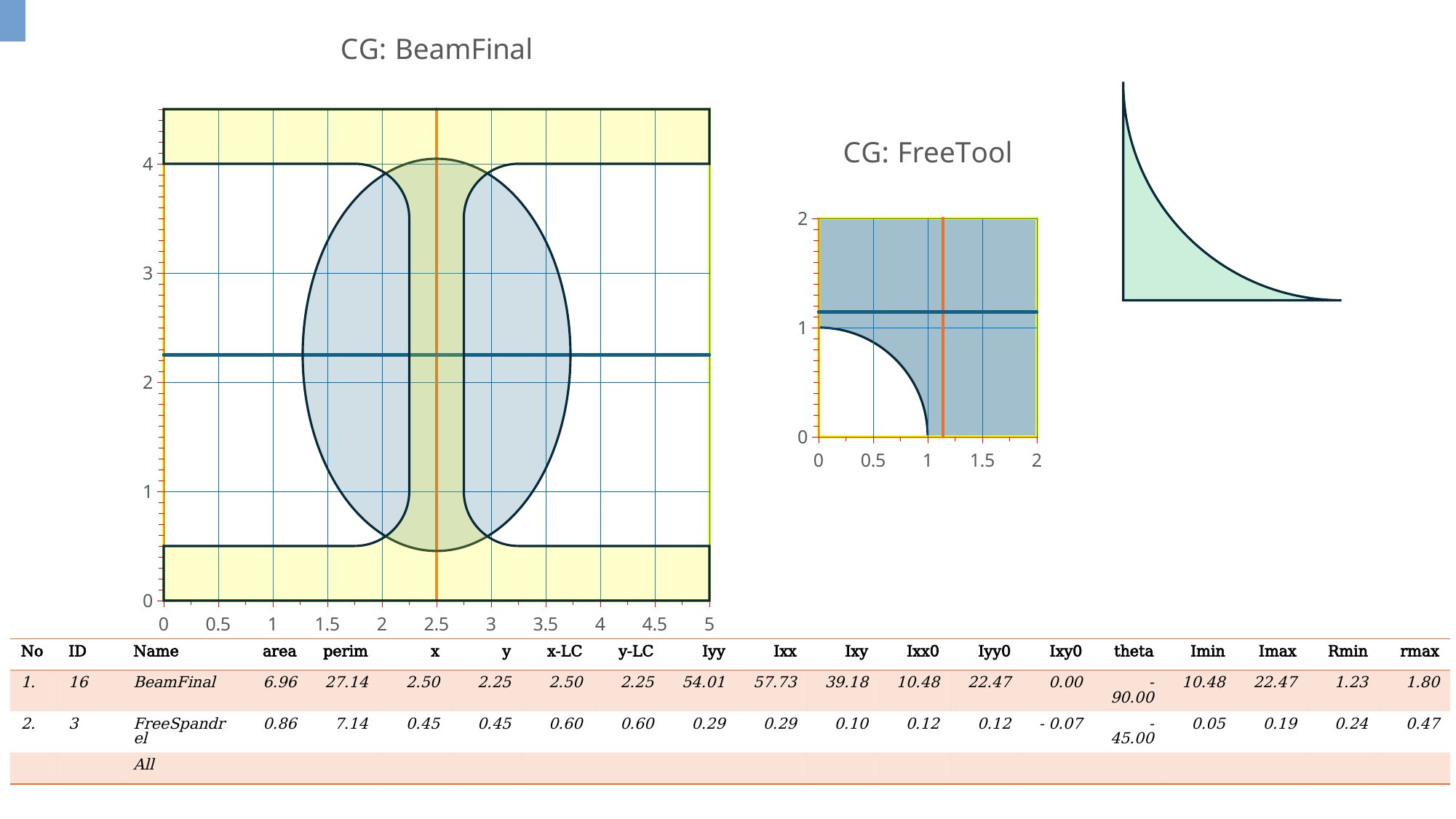
In the CG: FreeTool chart, is the vertical orange line located at an x value greater or less than 1? greater In the CG: FreeTool chart, is the horizontal dark line located at a y value greater or less than 1? greater What is the title of the large chart on the left of the slide? CG: BeamFinal In the CG: BeamFinal chart, at which x-axis value is the vertical orange line located? 2.5 What is the title of the smaller chart in the middle of the slide? CG: FreeTool In the CG: BeamFinal chart, is the horizontal dark line located at a y value greater or less than 2? greater